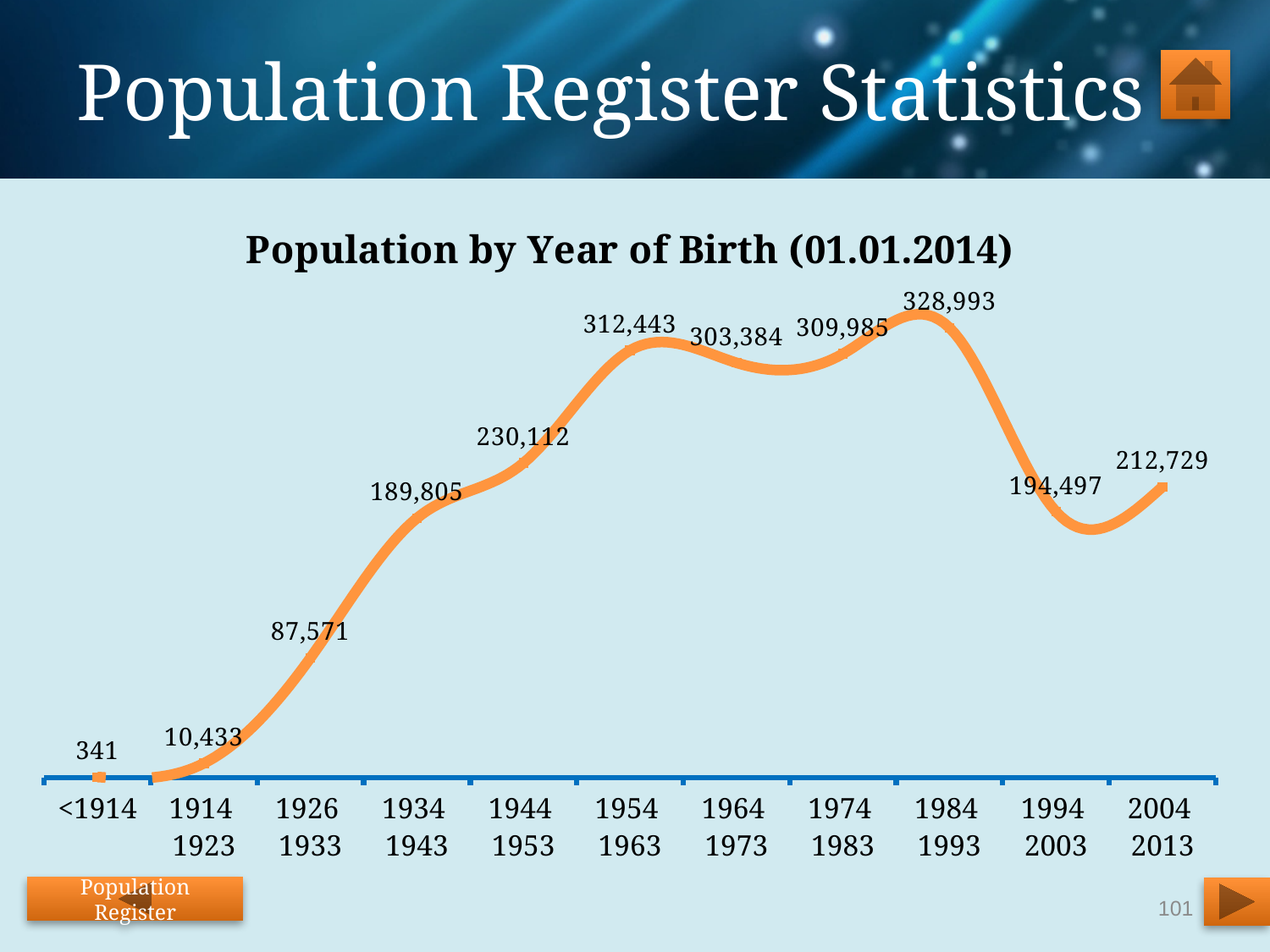
Which is larger, the population for 1954–1963 or for 1974–1983? 1954–1963 What is the population value for the <1914 birth-year group? 341 Which birth-year group has the highest population? 1984–1993 What is the population value for the 1944–1953 birth-year group? 230,112 What kind of chart is shown on the slide? Line chart What is the difference between the population values for the 2004–2013 and 1994–2003 groups? 18,232 Which birth-year group has the lowest population? <1914 What is the difference between the population values for the 1984–1993 and 1994–2003 groups? 134,496 How many birth-year groups are plotted on the chart? 11 What is the population value for the 1984–1993 birth-year group? 328,993 What is the population value for the 2004–2013 birth-year group? 212,729 What is the title of the chart? Population by Year of Birth (01.01.2014)